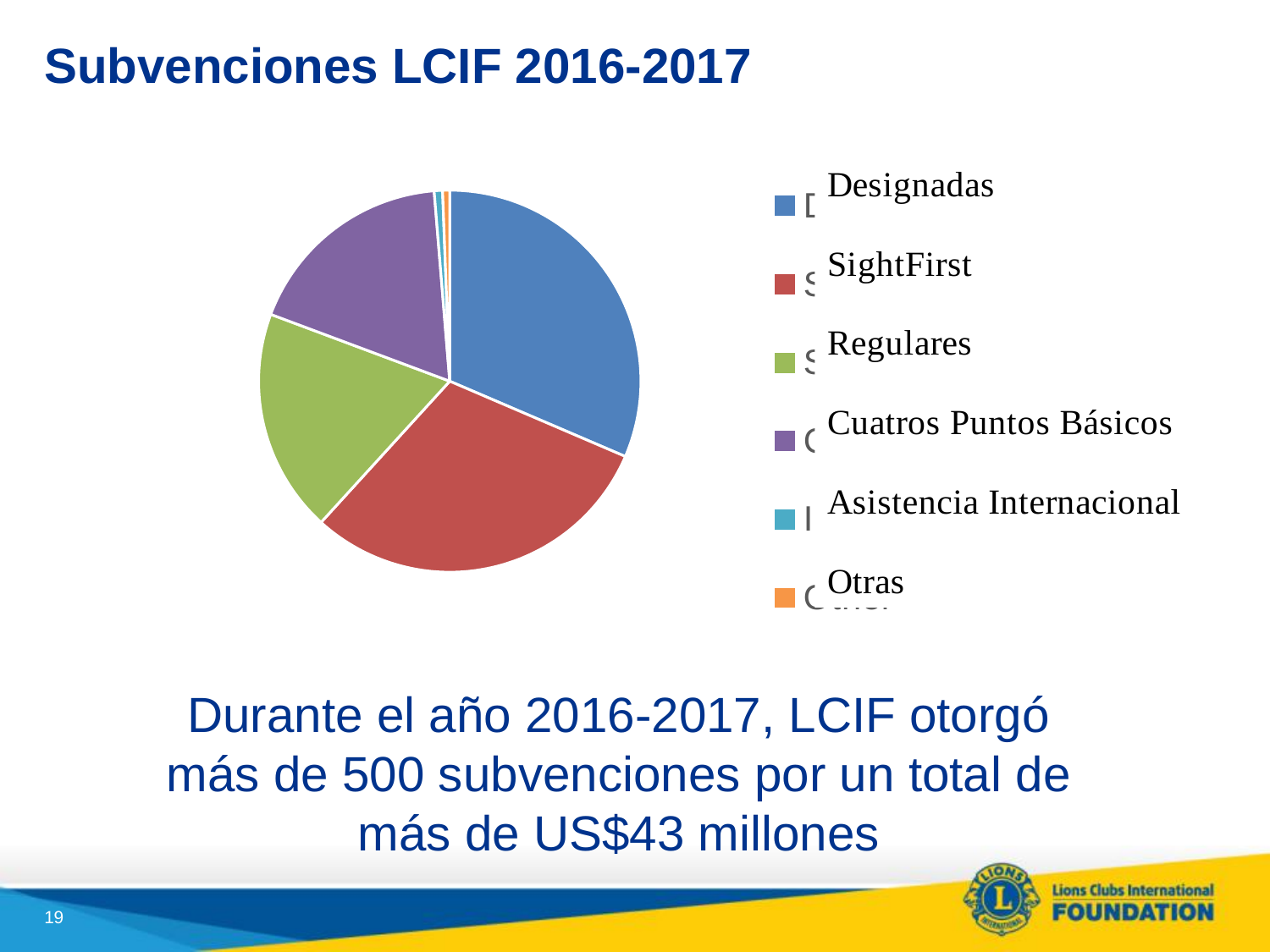
Which category is shown in blue in the pie chart? Designadas What kind of chart is shown on the slide? pie chart Which slice is larger in the pie chart, SightFirst or Cuatros Puntos Básicos? SightFirst Which slice is larger in the pie chart, Designadas or Otras? Designadas Which slice is larger in the pie chart, Cuatros Puntos Básicos or Asistencia Internacional? Cuatros Puntos Básicos How many categories does the legend of the pie chart list? 6 What is the title of the slide containing the pie chart? Subvenciones LCIF 2016-2017